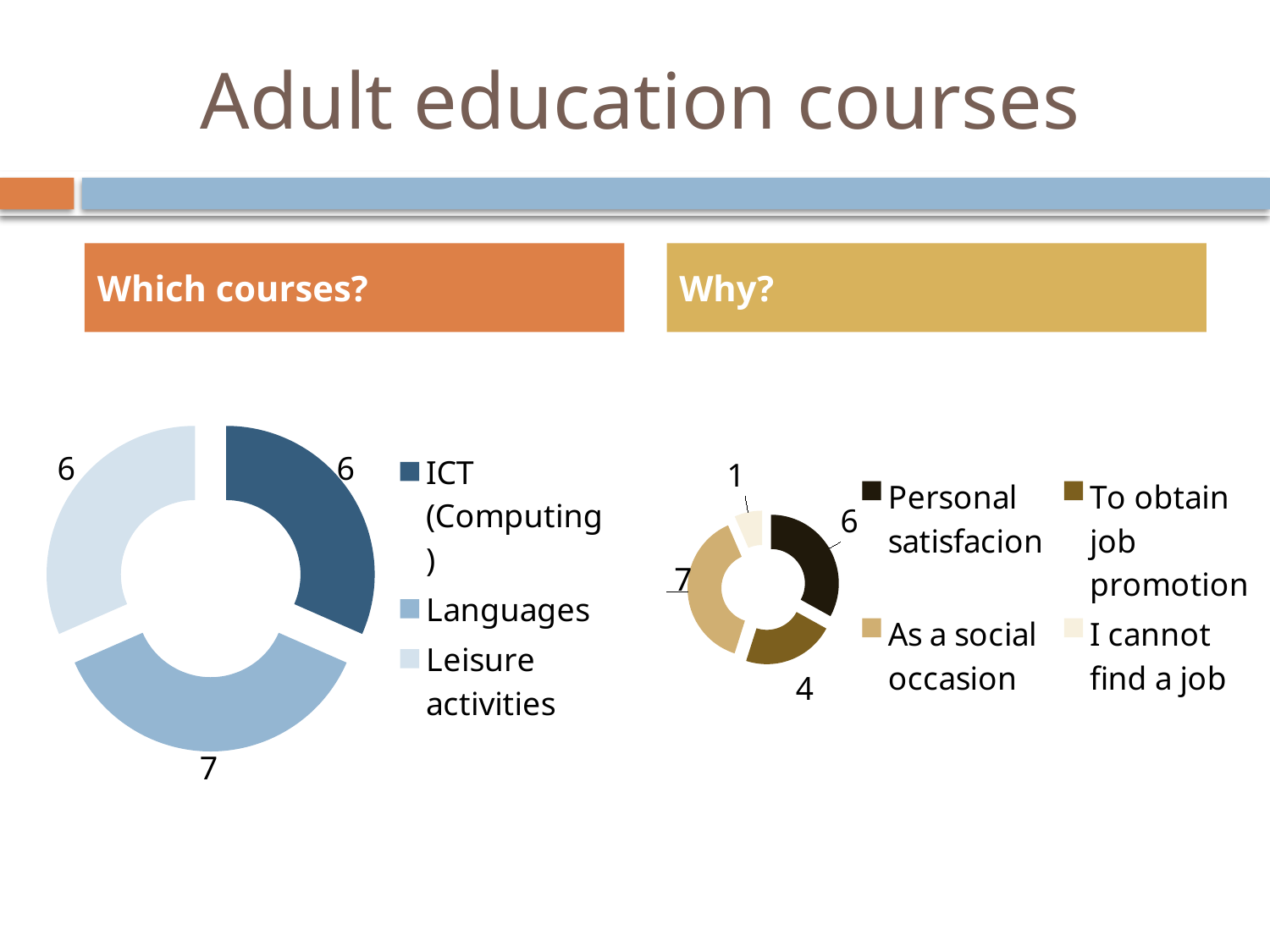
What kind of chart is the 'Which courses?' chart? Doughnut chart In the 'Which courses?' chart, what is the total of all the values? 19 In the 'Which courses?' chart, which category has the highest value? Languages In the 'Why?' chart, what is the value for As a social occasion? 7 In the 'Why?' chart, how many categories does the legend list? 4 In the 'Which courses?' chart, how many categories are shown? 3 In the 'Why?' chart, which category has the highest value? As a social occasion In the 'Why?' chart, what is the value for To obtain job promotion? 4 In the 'Why?' chart, which category has the lowest value? I cannot find a job In the 'Why?' chart, what is the difference between Personal satisfaction and To obtain job promotion? 2 In the 'Which courses?' chart, what is the value for ICT (Computing)? 6 In the 'Which courses?' chart, what is the value for Languages? 7